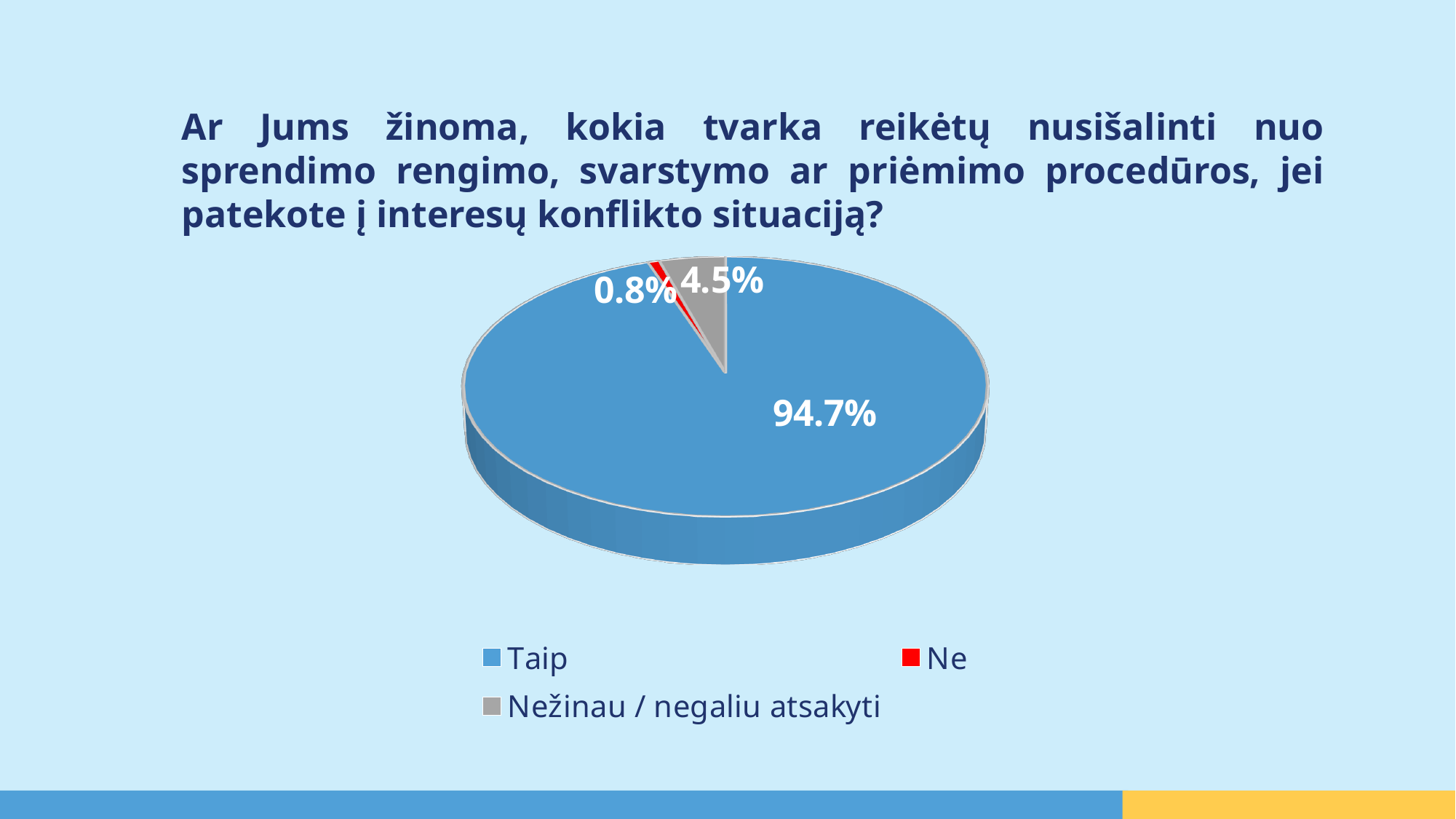
What colour is the slice for "Ne"? red Which is larger, the share for "Ne" or the share for "Nežinau / negaliu atsakyti"? Nežinau / negaliu atsakyti What colour is the slice for "Taip"? blue How many slices does the pie chart have? 3 How many entries does the legend list? 3 What share of the pie does "Ne" have? 0.8% What share of the pie does "Nežinau / negaliu atsakyti" have? 4.5% Which category has the largest slice of the pie? Taip What share of the pie does "Taip" have? 94.7% What is the difference between the shares for "Taip" and "Nežinau / negaliu atsakyti"? 90.2% Which category has the smallest slice of the pie? Ne What kind of chart is shown on the slide? pie chart